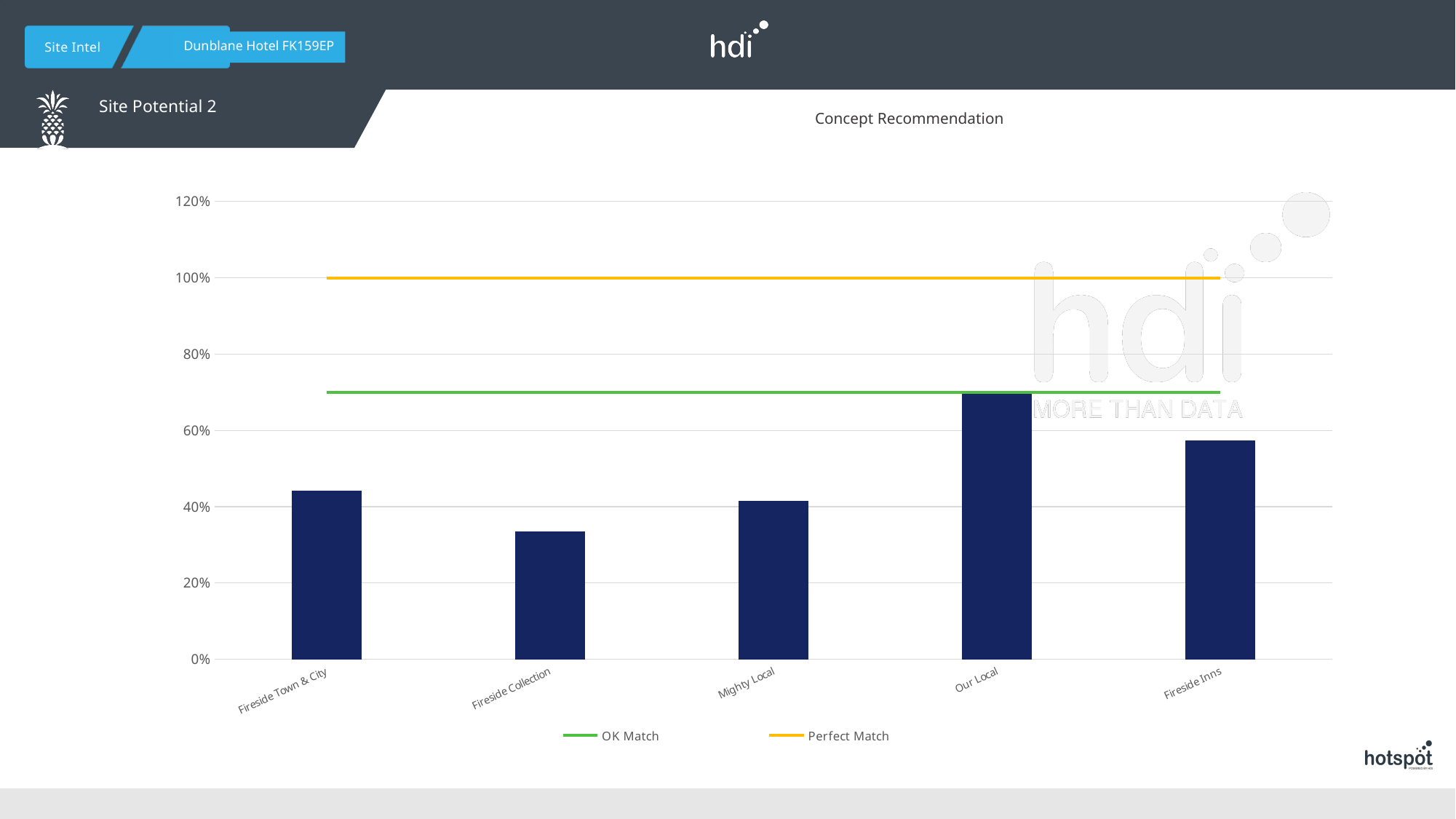
Is the value for Our Local greater or less than 60%? greater What kind of chart is shown on the slide? Combination bar and line chart Is the value for Fireside Collection greater or less than 40%? less Which is larger, the value for Fireside Town & City or the value for Fireside Collection? Fireside Town & City How many concept categories are plotted on the x axis? 5 Which concept has the highest bar? Our Local Which is larger, the value for Our Local or the value for Fireside Inns? Our Local How many entries does the legend list? 2 Is the value for Fireside Inns greater or less than 60%? less Which concept has the lowest bar? Fireside Collection What is the title of the chart? Concept Recommendation